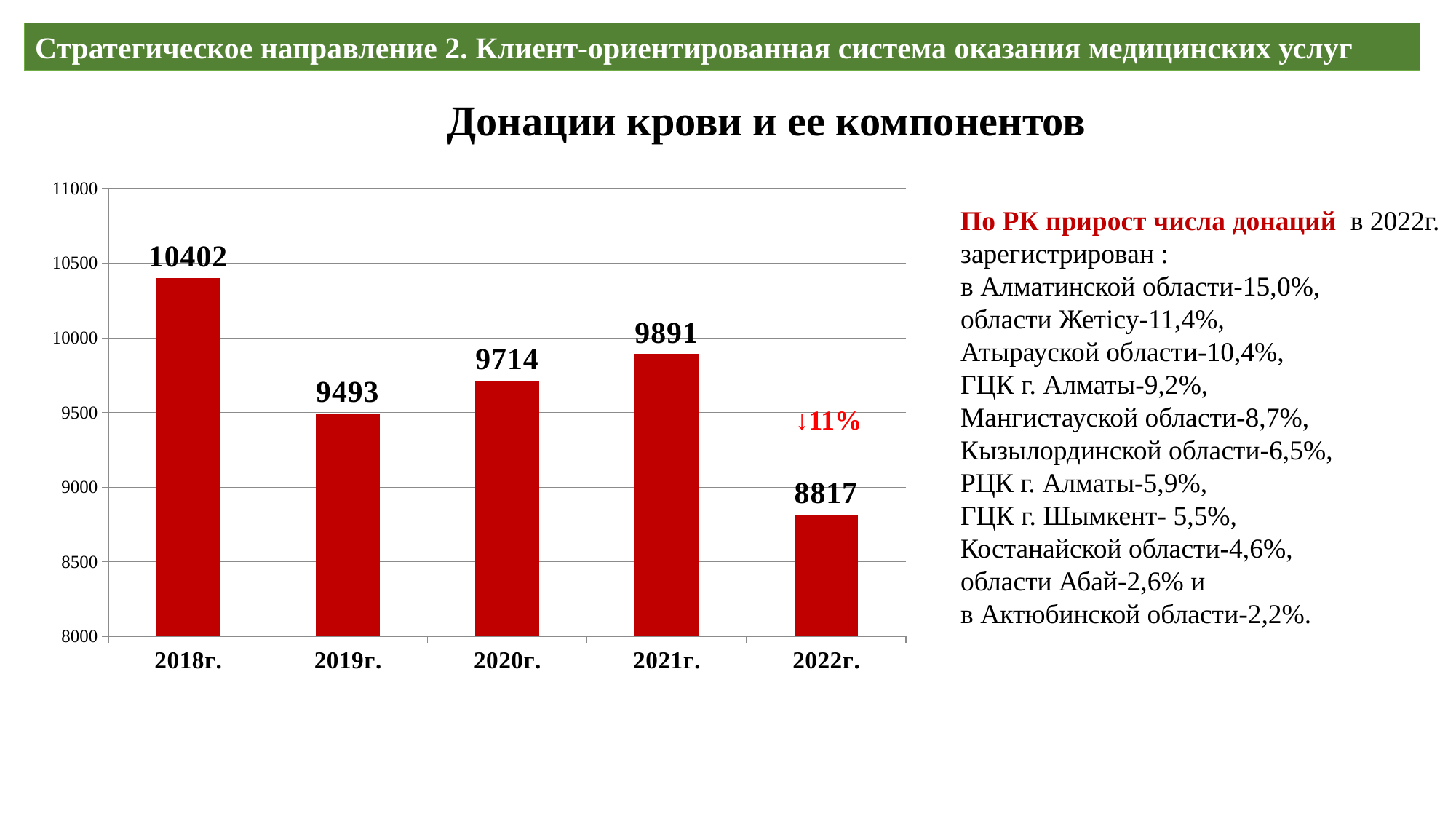
What is the title of the chart? Донации крови и ее компонентов Is the value for 2021г. greater or less than 10000? less Which year has the lowest value? 2022г. Which year has the highest value? 2018г. What kind of chart is shown on the slide? bar chart What is the value for 2022г.? 8817 What is the difference between the values for 2018г. and 2019г.? 909 How many years are shown on the chart? 5 What is the value for 2020г.? 9714 What is the difference between the values for 2021г. and 2022г.? 1074 Which is larger, the value for 2019г. or the value for 2020г.? 2020г. What is the value for 2018г.? 10402